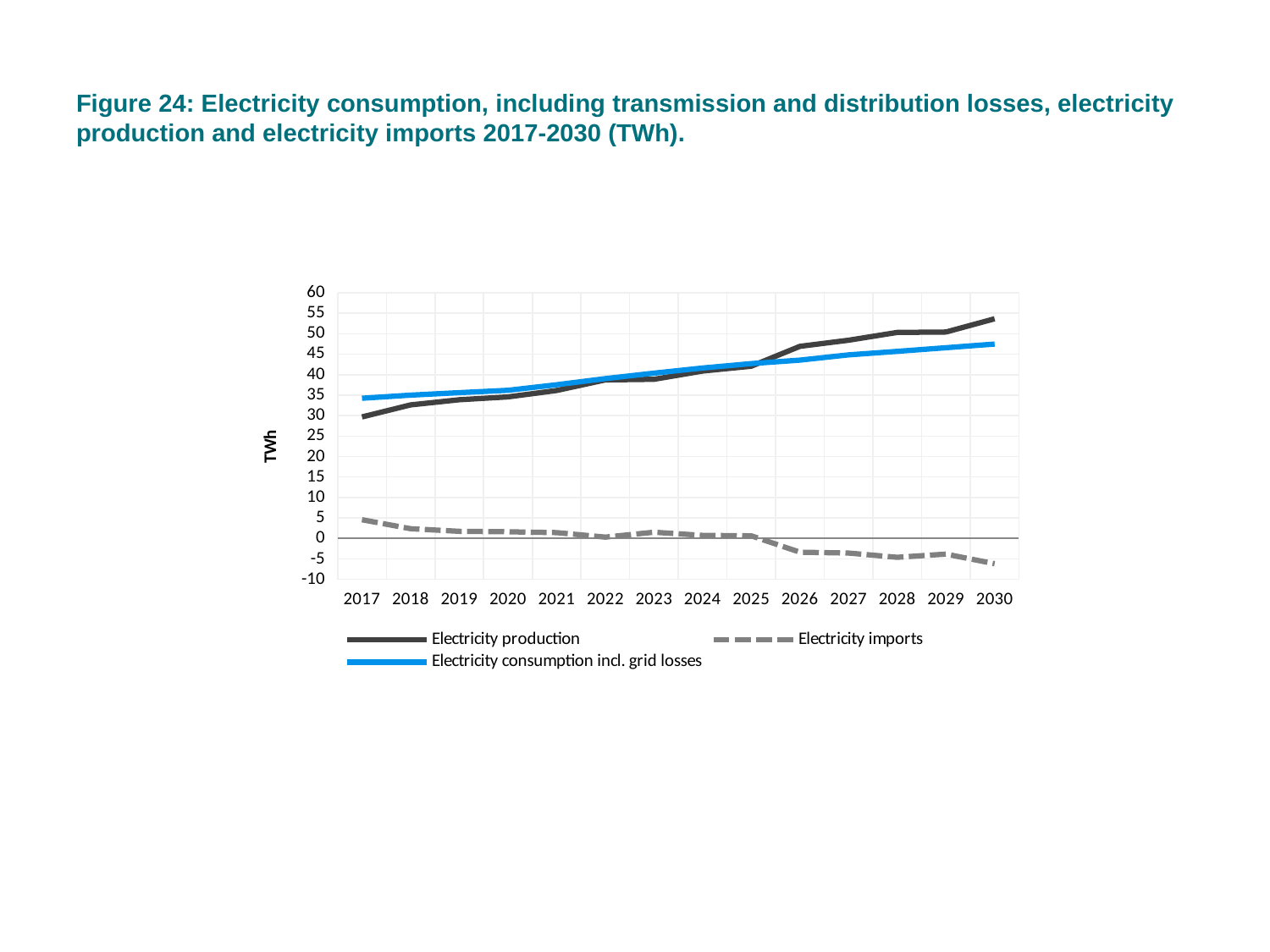
Does Electricity imports rise or fall from 2017 to 2030? fall What kind of chart is shown on the slide? line chart Is the value for Electricity imports in 2030 greater or less than 0? less How many series does the legend list? 3 In 2030, which is larger: Electricity production or Electricity consumption incl. grid losses? Electricity production Is the value for Electricity imports in 2017 greater or less than 0? greater Is the value for Electricity production in 2025 greater or less than 40? greater How many years are plotted along the x axis? 14 In which year is Electricity production highest? 2030 In which year is Electricity imports highest? 2017